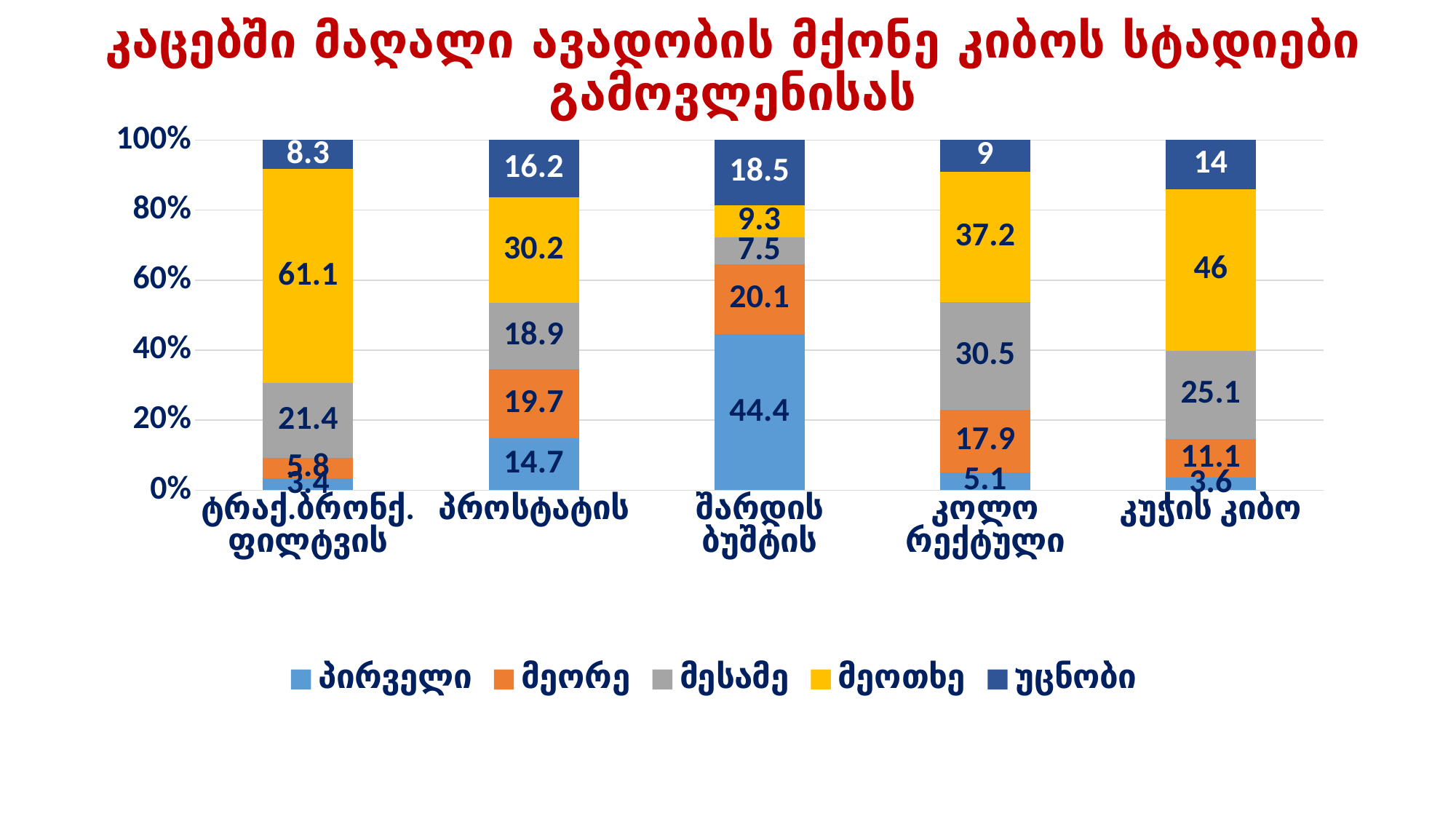
How many categories are shown on the x axis? 5 What is the value of the უცნობი series for კუჭის კიბო? 14 What is the difference between the მეოთხე values for კუჭის კიბო and კოლო რექტული? 8.8 How many series does the legend list? 5 Which colour represents the მეოთხე series in the legend? Yellow What is the value of the მესამე series for კოლო რექტული? 30.5 What is the value of the პირველი series for შარდის ბუშტის? 44.4 Which is larger: the უცნობი value for პროსტატის or for შარდის ბუშტის? შარდის ბუშტის Which category has the lowest value for the მეოთხე series? შარდის ბუშტის What kind of chart is shown on the slide? Stacked bar chart Which category has the highest value for the პირველი series? შარდის ბუშტის What is the value of the მეოთხე series for ტრაქ.ბრონქ. ფილტვის? 61.1